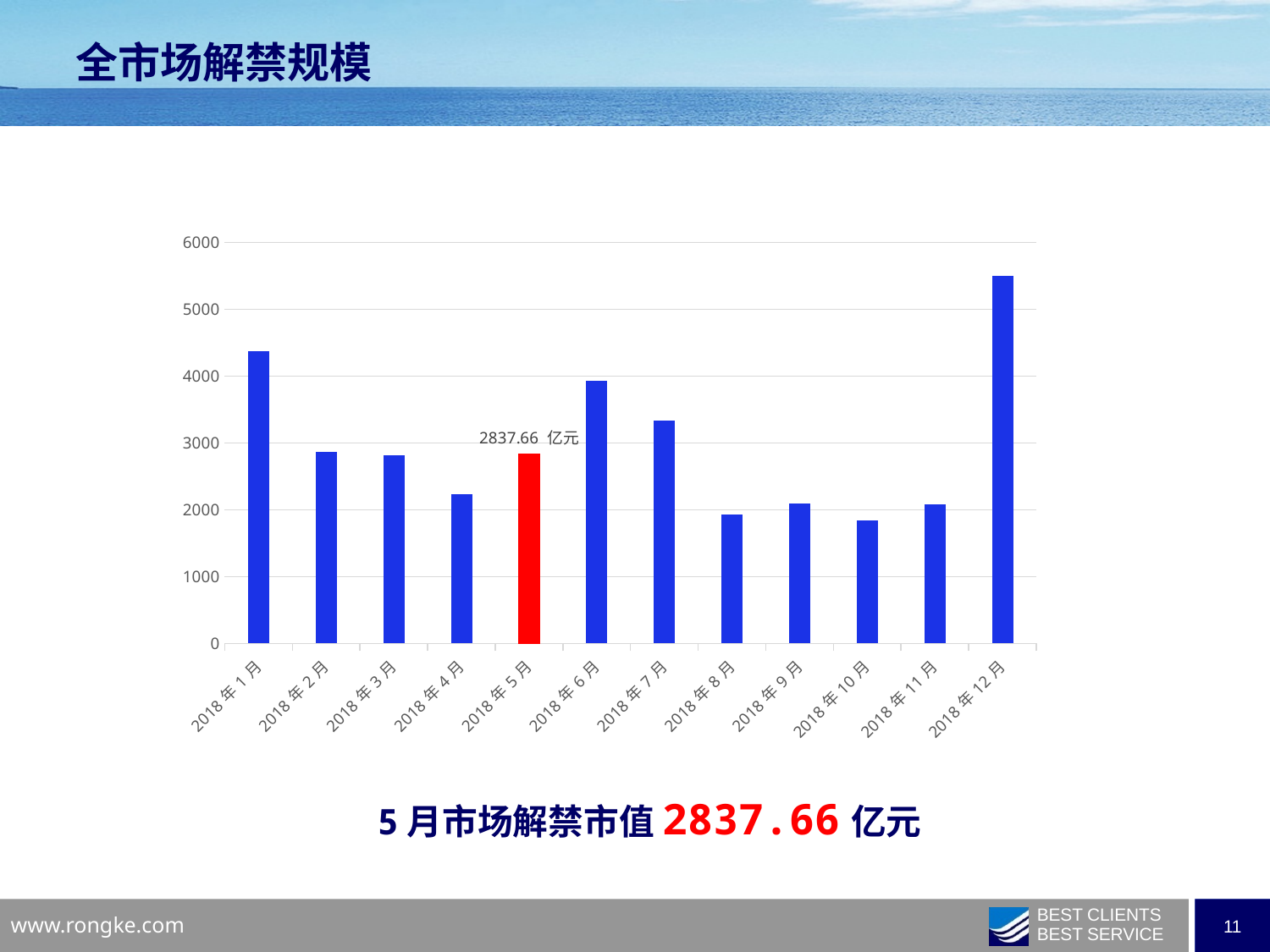
Which is larger, the value for 2018年6月 or 2018年10月? 2018年6月 How many months are shown on the x axis? 12 Which month has the highest value? 2018年12月 Is the value for 2018年8月 greater or less than 2000? less What is the value for 2018年5月? 2837.66 亿元 What is the title of the slide? 全市场解禁规模 Is the value for 2018年1月 greater or less than 4000? greater Is the value for 2018年7月 greater or less than 3000? greater What kind of chart is shown on the slide? bar chart Which is larger, the value for 2018年1月 or 2018年2月? 2018年1月